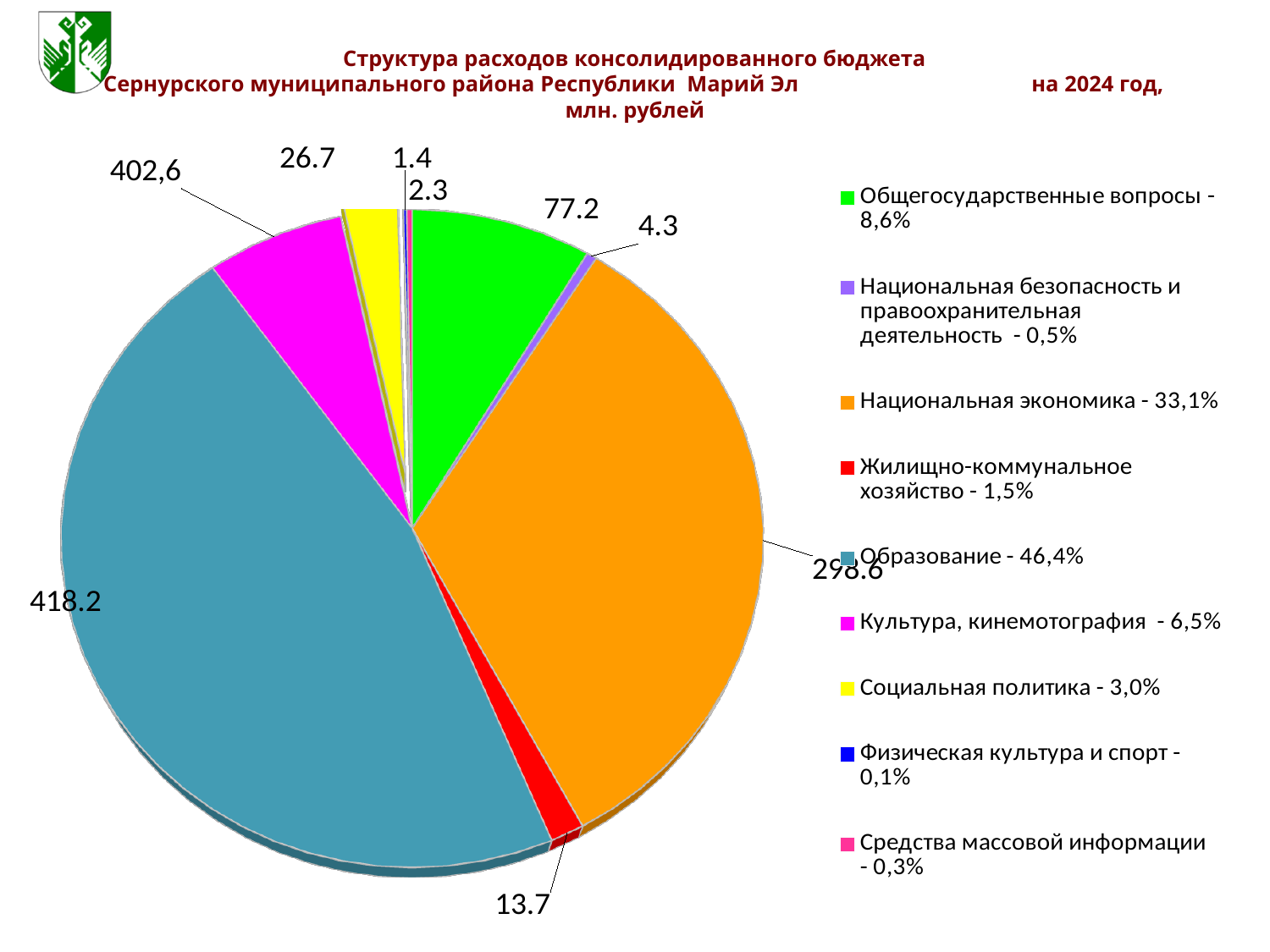
What colour is the Национальная экономика slice? orange How many categories does the legend of the pie chart list? 9 What value is printed for the Национальная экономика slice? 298.6 What is the difference between the values for Образование and Национальная экономика? 119.6 Which category has the largest slice of the pie? Образование Which category has the smallest slice of the pie? Физическая культура и спорт What share of the pie does Национальная экономика have? 33,1% What share of the pie does Образование have? 46,4% Which is larger, the value for Жилищно-коммунальное хозяйство or the value for Социальная политика? Социальная политика What value is printed for the Общегосударственные вопросы slice? 77.2 What value is printed for the Образование slice? 418.2 What kind of chart is shown on the slide? pie chart